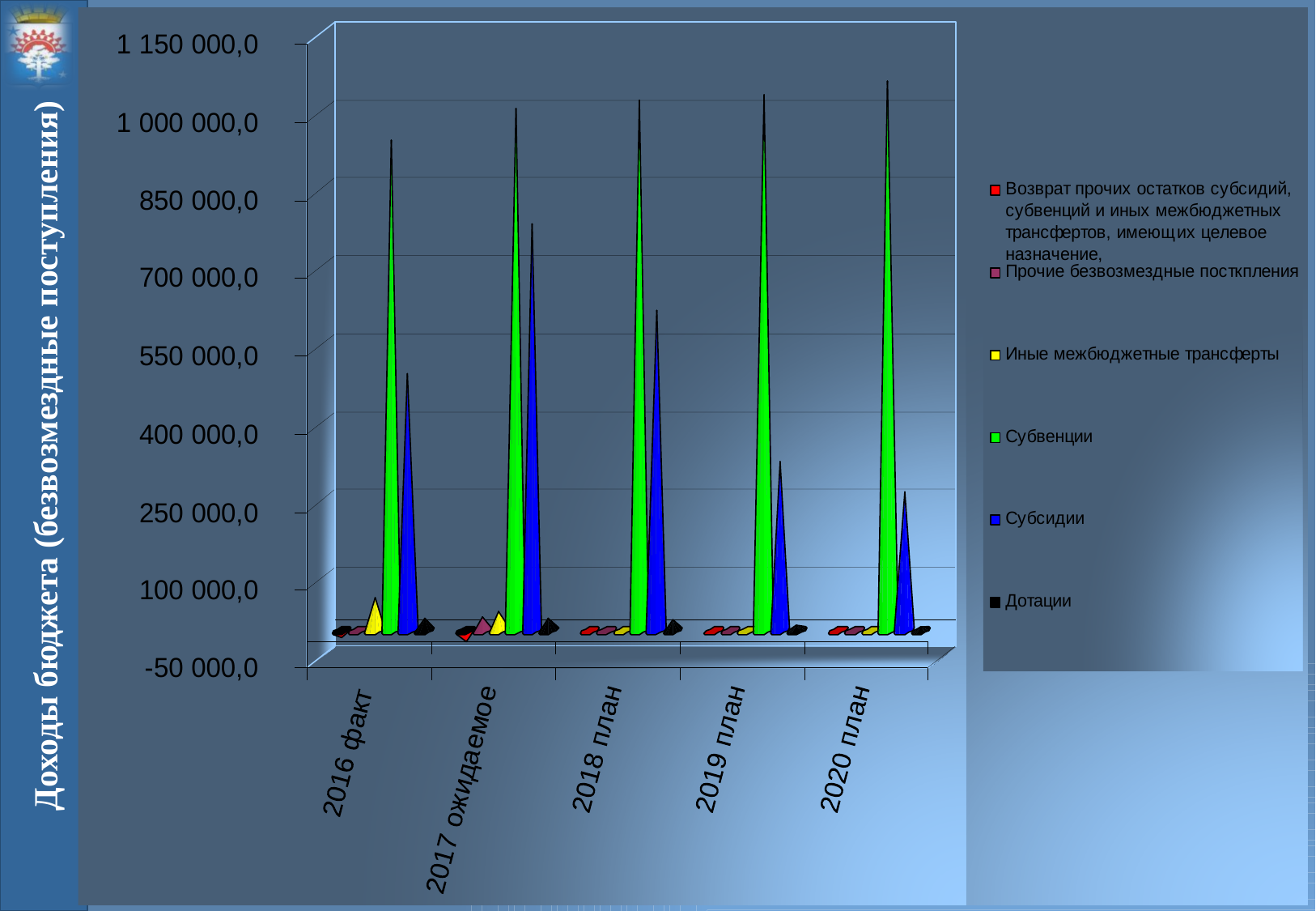
Is the value for Субсидии in 2020 план greater or less than 400 000,0? less In which category is the value for Субвенции lowest? 2016 факт Which is larger in 2018 план: Субвенции or Субсидии? Субвенции In which category is the value for Субсидии highest? 2017 ожидаемое Do the values for Субвенции rise or fall from 2016 факт to 2020 план? rise Is the value for Субсидии in 2017 ожидаемое greater or less than 550 000,0? greater In which category is the value for Субсидии lowest? 2020 план In which category is the value for Субвенции highest? 2020 план What kind of chart is shown on the slide? bar chart What colour represents Субвенции in the chart? green How many categories are shown along the x axis? 5 How many series does the legend list? 6